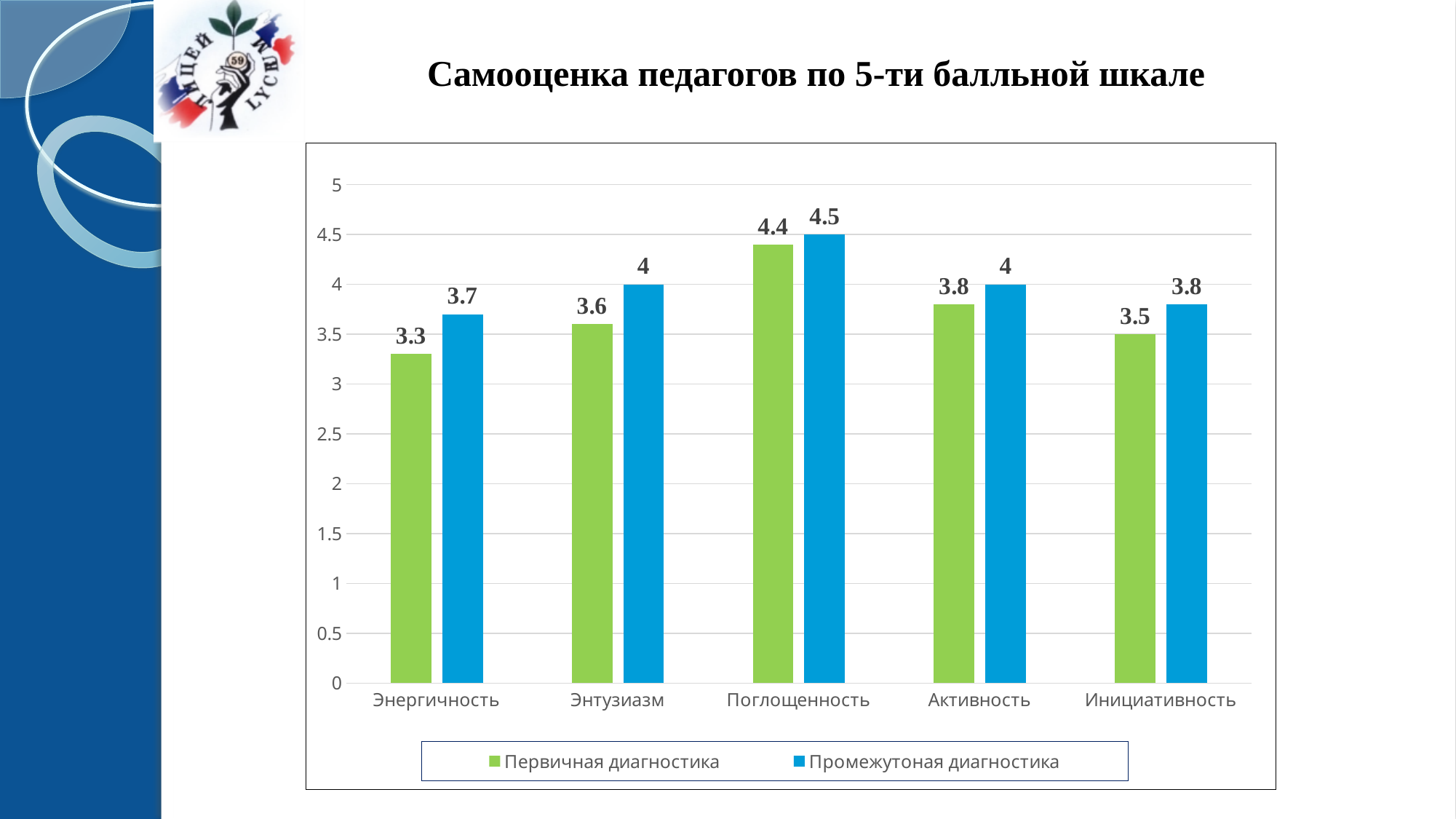
Which category has the lowest value in the Первичная диагностика series? Энергичность How many categories are shown on the x axis? 5 What is the value for Энергичность in the Первичная диагностика series? 3.3 Is the Первичная диагностика value for Поглощенность greater or less than 4? greater What is the difference between the Промежутоная диагностика and Первичная диагностика values for Энтузиазм? 0.4 How many series does the legend list? 2 What kind of chart is shown on the slide? bar chart What is the title of the chart on the slide? Самооценка педагогов по 5-ти балльной шкале Which is larger for Активность: the Первичная диагностика value or the Промежутоная диагностика value? Промежутоная диагностика What is the value for Поглощенность in the Промежутоная диагностика series? 4.5 What is the value for Инициативность in the Первичная диагностика series? 3.5 Which category has the highest value in the Промежутоная диагностика series? Поглощенность